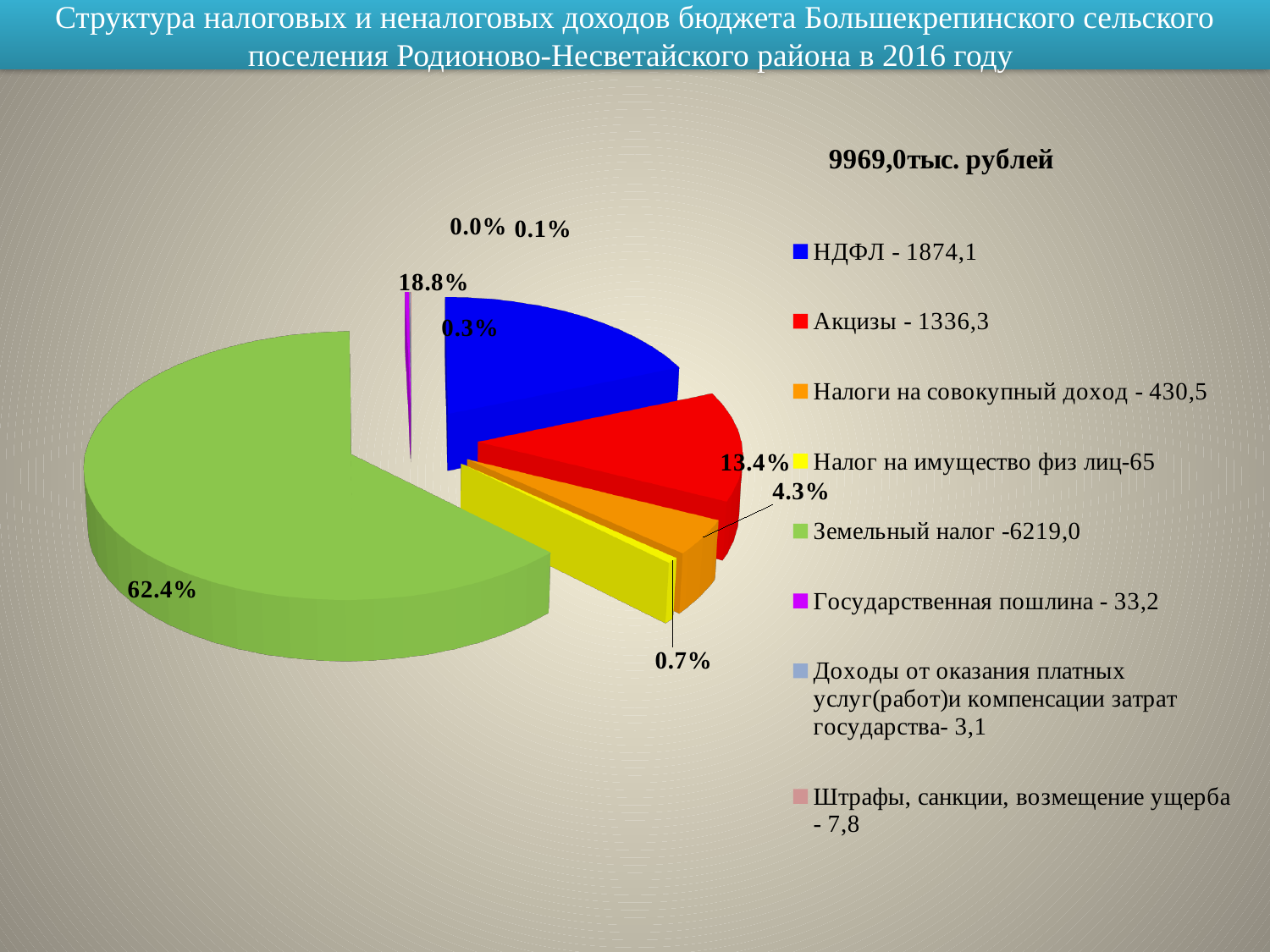
Which category has the largest share of the pie? Земельный налог What is the value shown in the legend for Земельный налог? 6219,0 What is the difference between the values for НДФЛ and Акцизы? 537,8 What is the value shown in the legend for Государственная пошлина? 33,2 What percentage share of the pie does Акцизы have? 13.4% What is the value shown in the legend for Акцизы? 1336,3 What percentage share of the pie does Земельный налог have? 62.4% Which is larger, the value for Налоги на совокупный доход or the value for Налог на имущество физ лиц? Налоги на совокупный доход How many categories does the legend list? 8 Which category has the smallest value in the legend? Доходы от оказания платных услуг(работ)и компенсации затрат государства What is the value shown in the legend for НДФЛ? 1874,1 What type of chart is shown on the slide? Pie chart